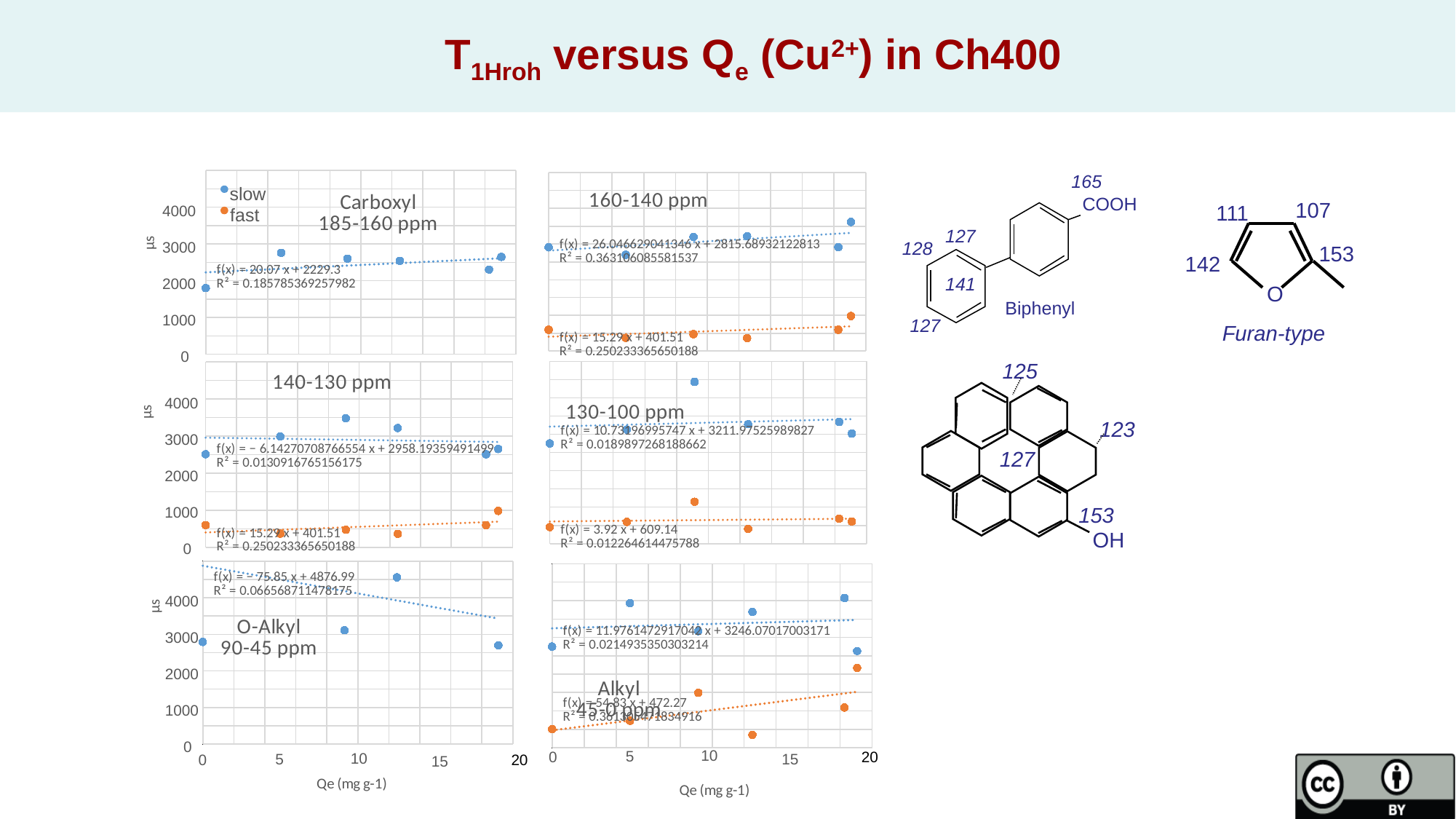
What is the x-axis label of the O-Alkyl 90-45 ppm chart? Qe (mg g-1) How many series does the legend in the Carboxyl 185-160 ppm chart list? 2 In the 160-140 ppm chart, which series has the higher values, slow or fast? slow What are the two legend entries in the Carboxyl 185-160 ppm chart? slow, fast What kind of chart is the Carboxyl 185-160 ppm chart? Scatter chart In the 130-100 ppm chart, is the highest slow value greater or less than 4000? greater In the O-Alkyl 90-45 ppm chart, what is the trendline equation printed on the chart? f(x) = − 75.85 x + 4876.99 In the 130-100 ppm chart, what is the R² value printed for the fast series trendline? 0.012264614475788 In the 140-130 ppm chart, is the fast value at Qe of about 12 greater or less than 1000? less How many charts are shown on the slide? 6 In the O-Alkyl 90-45 ppm chart, does the slow trendline rise or fall as Qe increases? Fall In the Carboxyl 185-160 ppm chart, what is the R² value printed for the trendline? 0.185785369257982